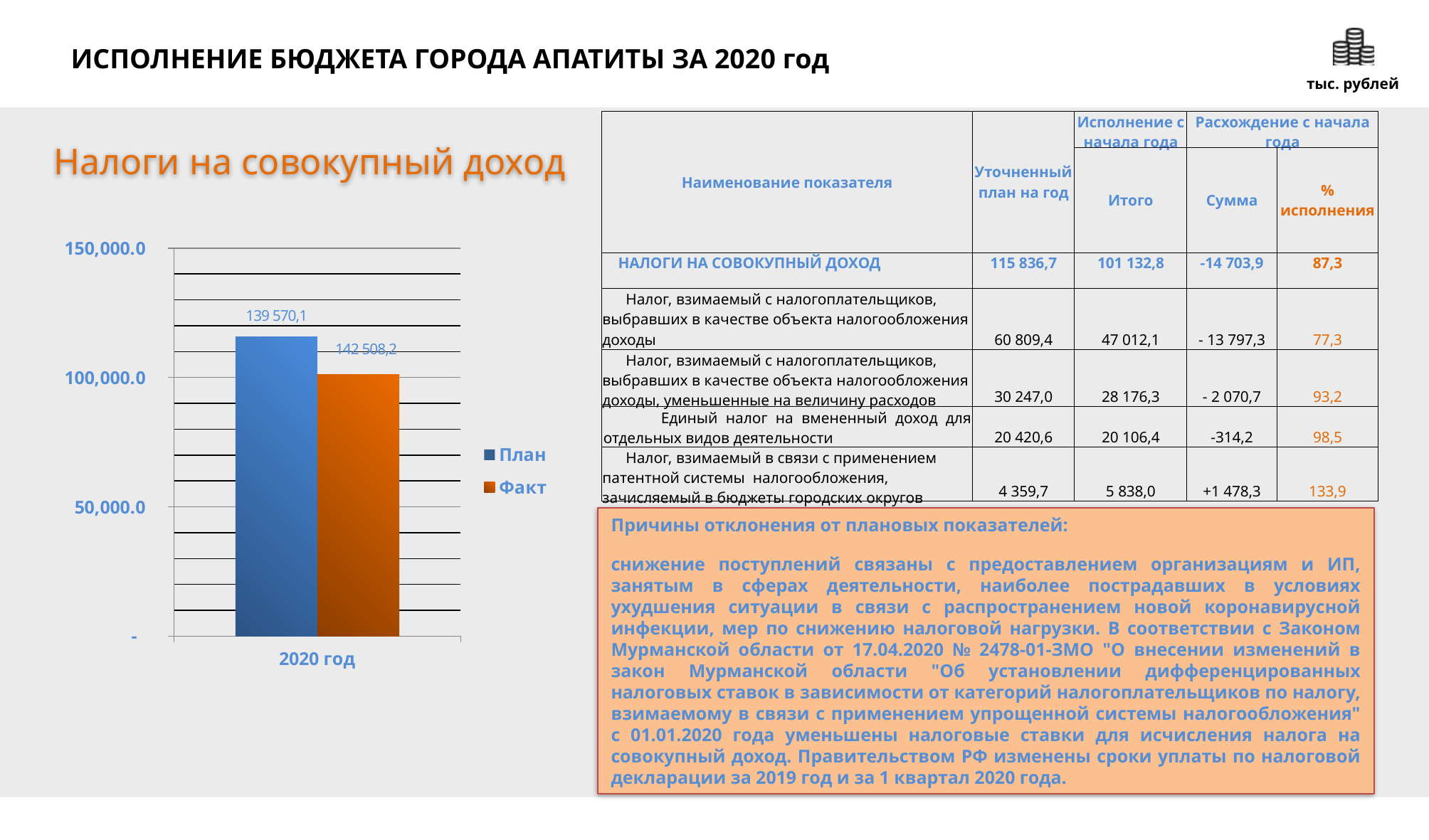
What are the series names listed in the chart legend? План, Факт What category label is shown on the x axis of the chart? 2020 год What type of chart is shown on the slide? bar chart What is the data label shown on the Факт bar for 2020 год? 142 508,2 How many series does the chart legend list? 2 Is the План bar for 2020 год greater or less than 150,000.0 on the axis? less Is the План bar for 2020 год greater or less than 100,000.0 on the axis? greater What is the data label shown on the План bar for 2020 год? 139 570,1 Is the Факт bar for 2020 год greater or less than 150,000.0 on the axis? less What is the title of the chart on the slide? Налоги на совокупный доход How many categories are shown on the x axis of the chart? 1